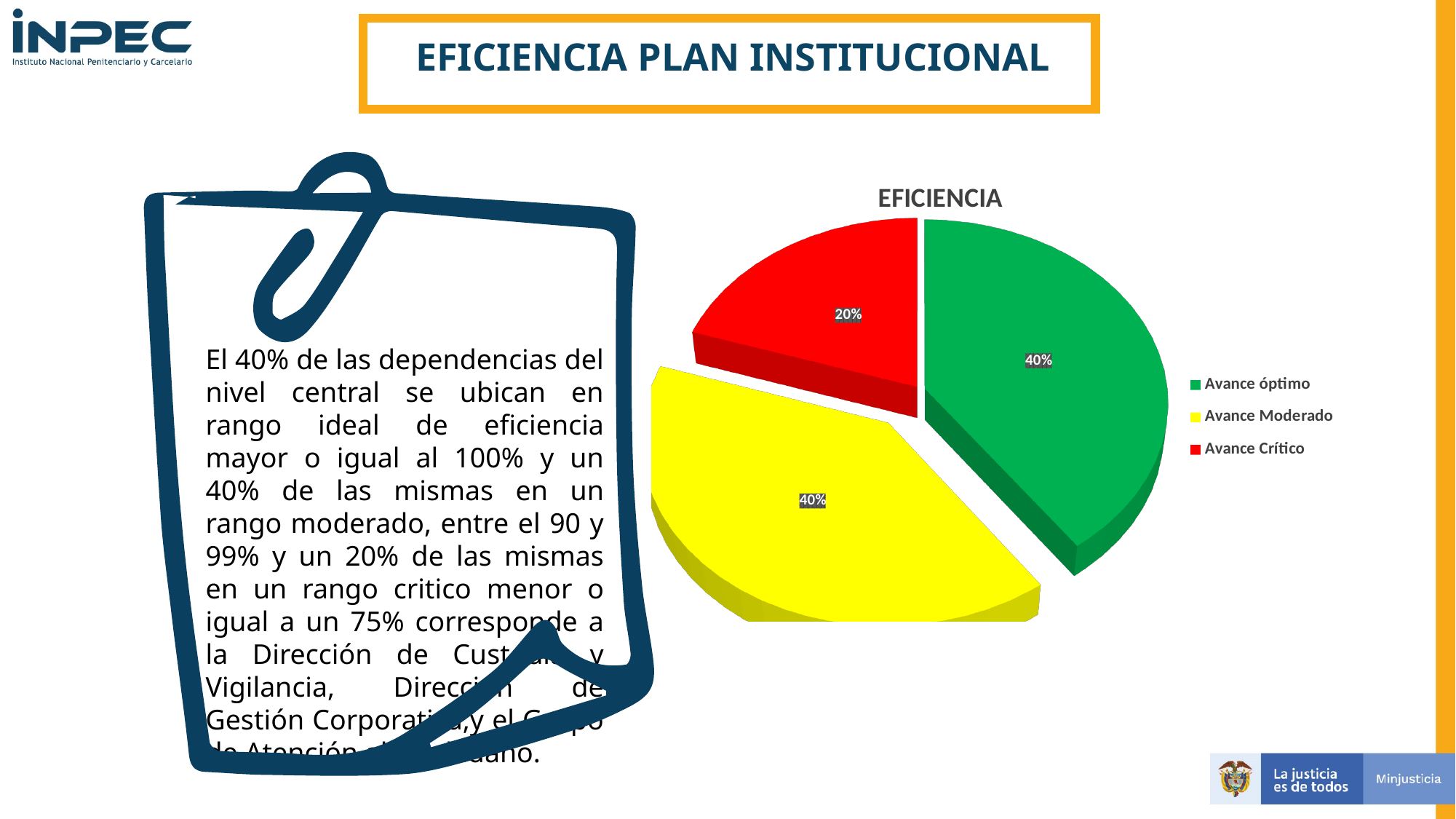
What type of chart is shown on the slide? Pie chart Which category has the smallest slice of the pie? Avance Crítico What colour is the Avance Crítico slice? Red Which is larger, the slice for Avance óptimo or the slice for Avance Crítico? Avance óptimo What is the difference between the Avance Moderado share and the Avance Crítico share? 20% What share of the pie does Avance Moderado represent? 40% What is the title of the chart? EFICIENCIA What share of the pie does Avance Crítico represent? 20% How many categories does the legend list? 3 What share of the pie does Avance óptimo represent? 40% Is the share for Avance Crítico greater or less than 30%? less